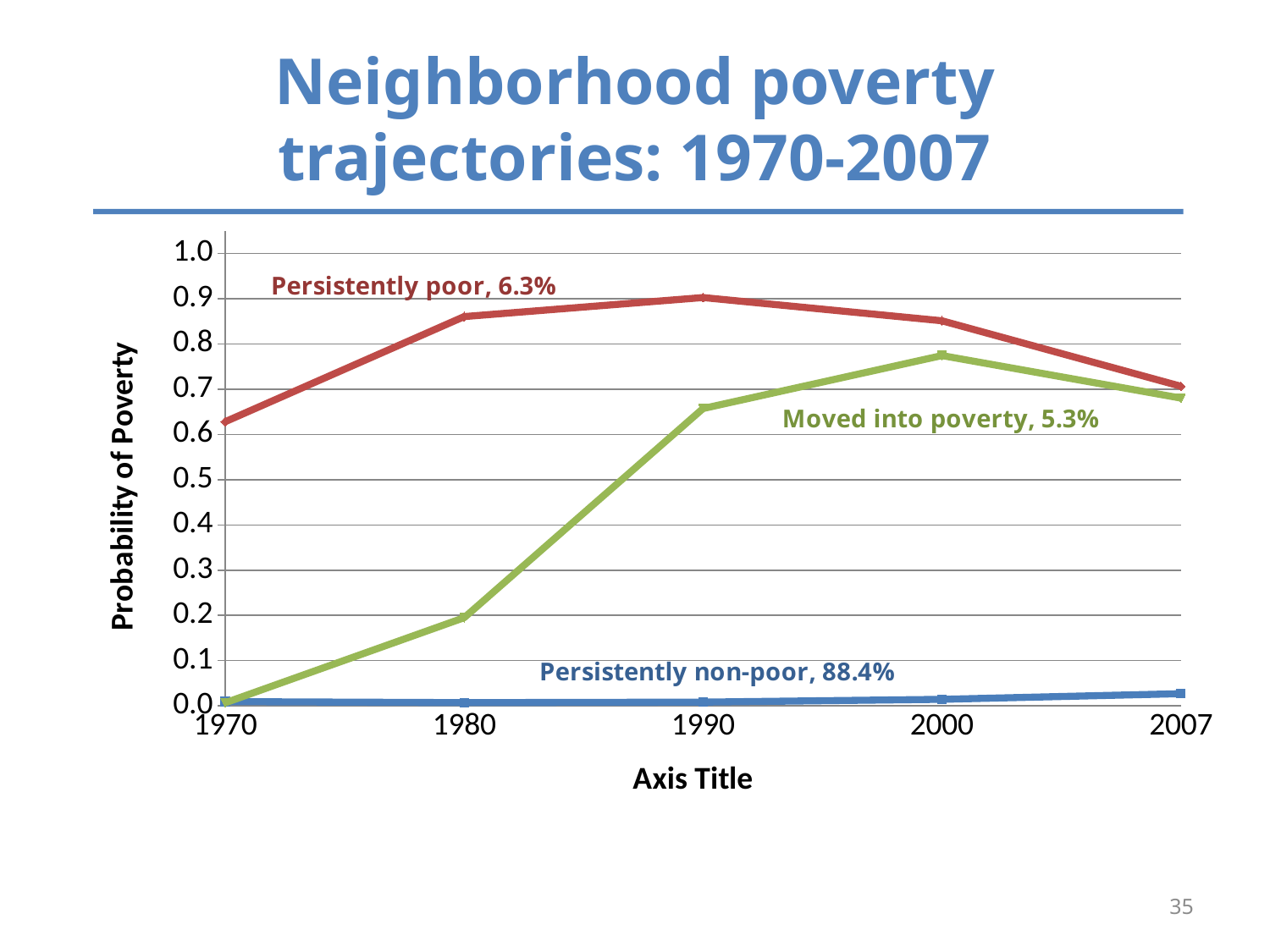
In which year is the Moved into poverty line at its lowest? 1970 What percentage is printed next to the Moved into poverty line? 5.3% In which year does the Persistently poor line reach its highest probability of poverty? 1990 Is the probability of poverty for Persistently poor in 1990 greater or less than 0.8? greater Does the Moved into poverty line rise or fall between 1970 and 2000? rise How many years are marked along the x axis of the chart? 5 Is the probability of poverty for Moved into poverty in 1980 greater or less than 0.3? less In which year does the Moved into poverty line reach its highest probability of poverty? 2000 What type of chart is shown on the slide? line chart In 2000, which line is higher: Persistently poor or Moved into poverty? Persistently poor What percentage is printed next to the Persistently non-poor line? 88.4% How many lines (series) are plotted in the chart? 3